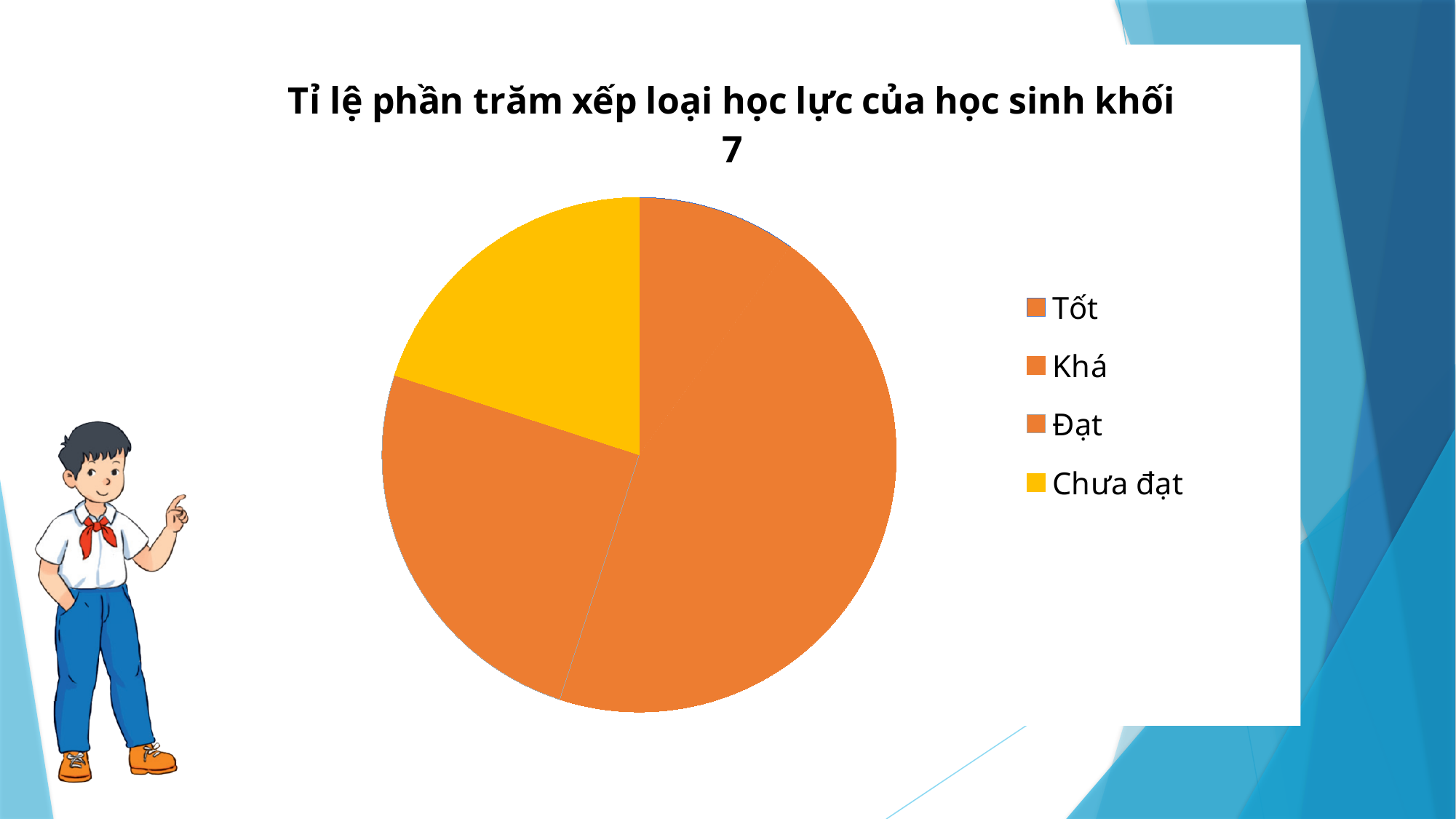
Is the share of the pie for Chưa đạt greater or less than 10%? greater Is the share of the pie for Chưa đạt greater or less than 50%? less Which category is shown in yellow in the chart? Chưa đạt What kind of chart is shown on the slide? pie chart What is the title of the chart? Tỉ lệ phần trăm xếp loại học lực của học sinh khối 7 How many categories does the legend of the chart list? 4